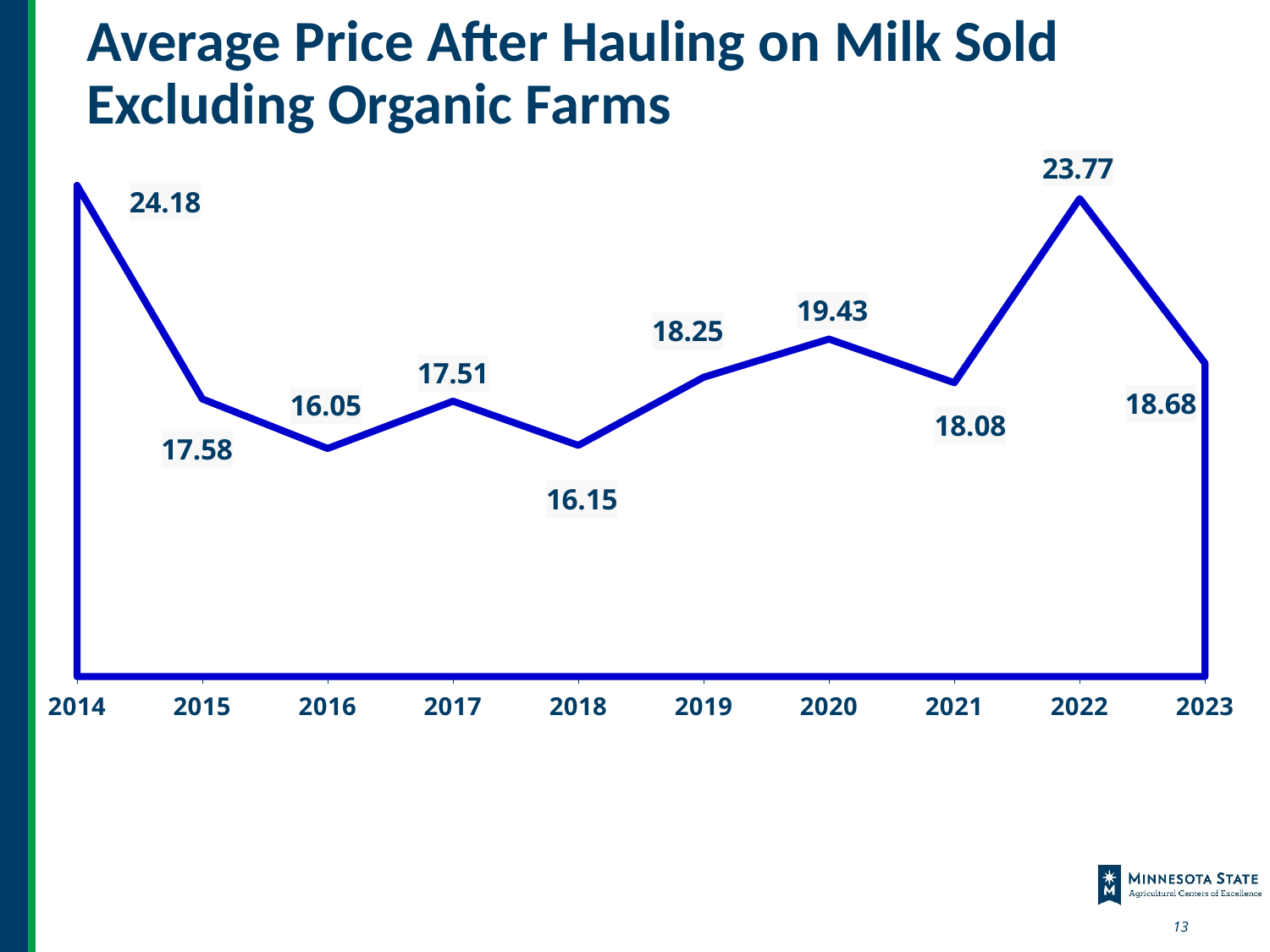
Does the value rise or fall from 2021 to 2022? rise Which year has the highest average price after hauling? 2014 Which year has the lowest average price after hauling? 2016 What is the value shown for 2018? 16.15 Which is larger, the value for 2020 or the value for 2019? 2020 How many years are plotted on the chart? 10 What kind of chart is shown on the slide? line chart What is the average price after hauling on milk sold in 2014? 24.18 What is the difference between the values for 2022 and 2021? 5.69 What is the value shown for 2022? 23.77 What is the difference between the values for 2014 and 2015? 6.60 What is the value shown for 2023? 18.68